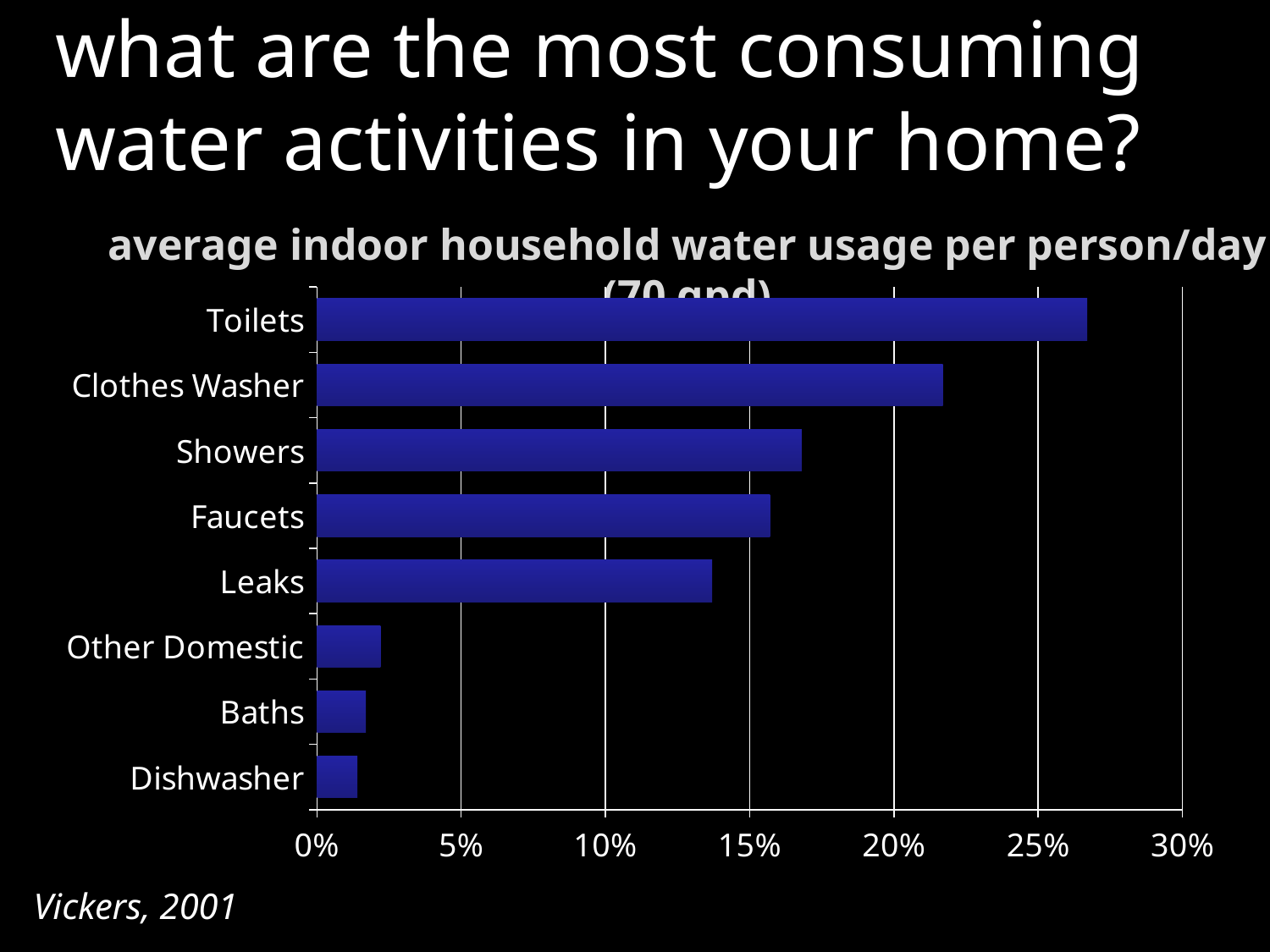
Is the value for Leaks greater or less than 15%? less Which is larger, the value for Leaks or the value for Baths? Leaks Is the value for Other Domestic greater or less than 5%? less How many household activities are listed on the chart? 8 Is the value for Clothes Washer greater or less than 20%? greater Which activity has the highest share of indoor household water usage? Toilets Which is larger, the value for Toilets or the value for Clothes Washer? Toilets What kind of chart is shown on the slide? bar chart What source is cited at the bottom of the slide? Vickers, 2001 Do the bar values decrease or increase going from the top category to the bottom category? decrease